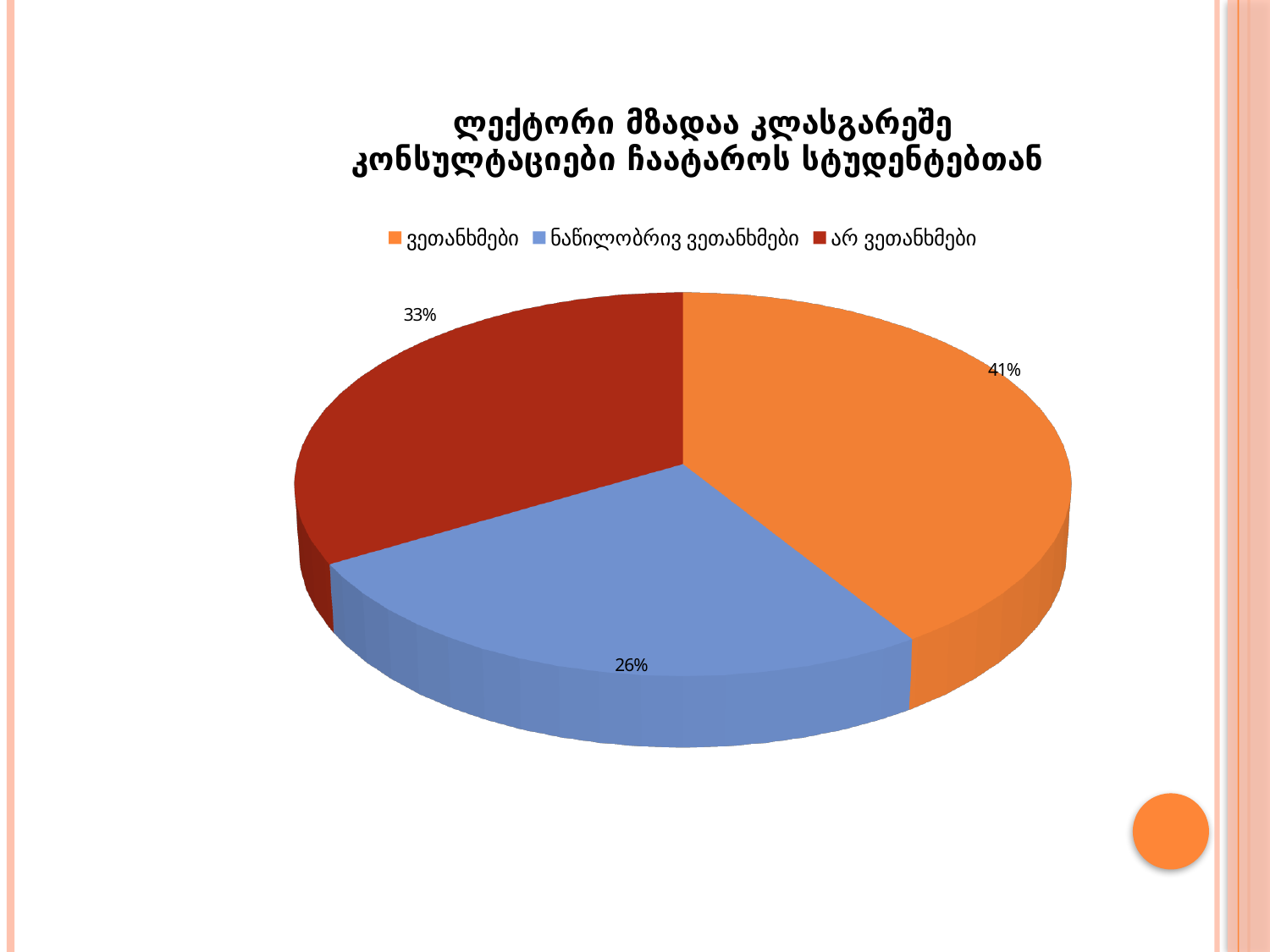
Which category has the largest share of the pie? ვეთანხმები Which category has the smallest share of the pie? ნაწილობრივ ვეთანხმები What percentage of the pie is labelled for ნაწილობრივ ვეთანხმები? 26% What is the difference in percentage points between ვეთანხმები and არ ვეთანხმები? 8 How many entries does the legend list? 3 What colour is the slice for ნაწილობრივ ვეთანხმები? blue What kind of chart is shown on the slide? pie chart What percentage of the pie is labelled for არ ვეთანხმები? 33% What is the difference in percentage points between ვეთანხმები and ნაწილობრივ ვეთანხმები? 15 Which is larger, the share for არ ვეთანხმები or the share for ნაწილობრივ ვეთანხმები? არ ვეთანხმები What percentage of the pie is labelled for ვეთანხმები? 41% How many slices does the pie chart have? 3